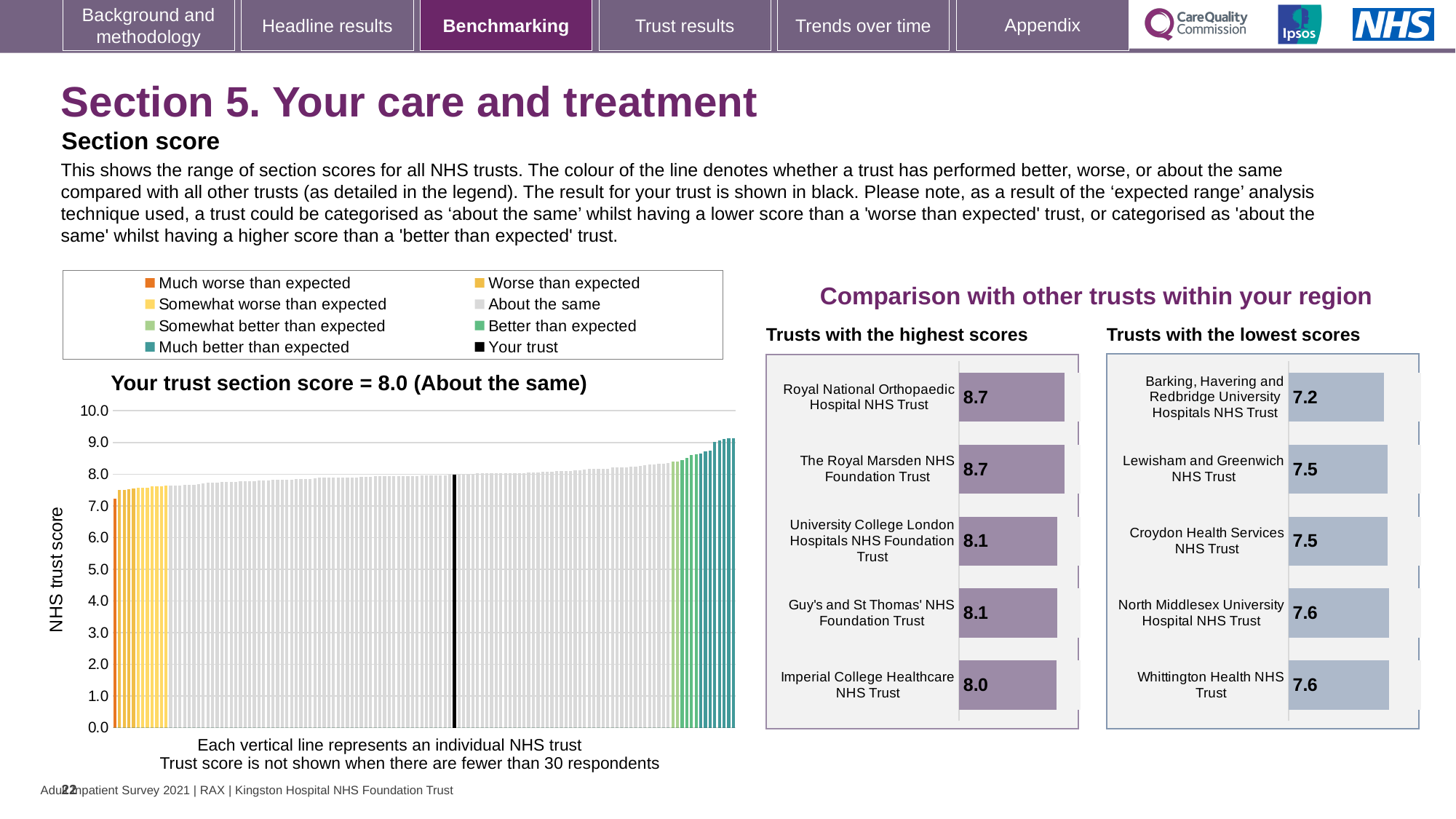
In the 'Trusts with the highest scores' chart, what is the difference between the score for Royal National Orthopaedic Hospital NHS Trust and the score for Imperial College Healthcare NHS Trust? 0.7 In the 'Your trust section score' chart, what is the label on the vertical axis? NHS trust score What kind of chart is the 'Your trust section score' chart? bar chart In the 'Your trust section score' chart, do the bars rise or fall from left to right? rise In the 'Trusts with the highest scores' chart, how many trusts are shown? 5 In the 'Your trust section score' chart, what is the section score for your trust? 8.0 In the 'Trusts with the highest scores' chart, what is the score for Imperial College Healthcare NHS Trust? 8.0 In the 'Trusts with the lowest scores' chart, which trust has the lowest score? Barking, Havering and Redbridge University Hospitals NHS Trust How many entries does the legend above the 'Your trust section score' chart list? 8 In the 'Your trust section score' chart, is the value of the leftmost bar greater or less than 8.0? less In the 'Trusts with the lowest scores' chart, which has the higher score: Lewisham and Greenwich NHS Trust or Whittington Health NHS Trust? Whittington Health NHS Trust In the 'Trusts with the lowest scores' chart, what is the score for Croydon Health Services NHS Trust? 7.5